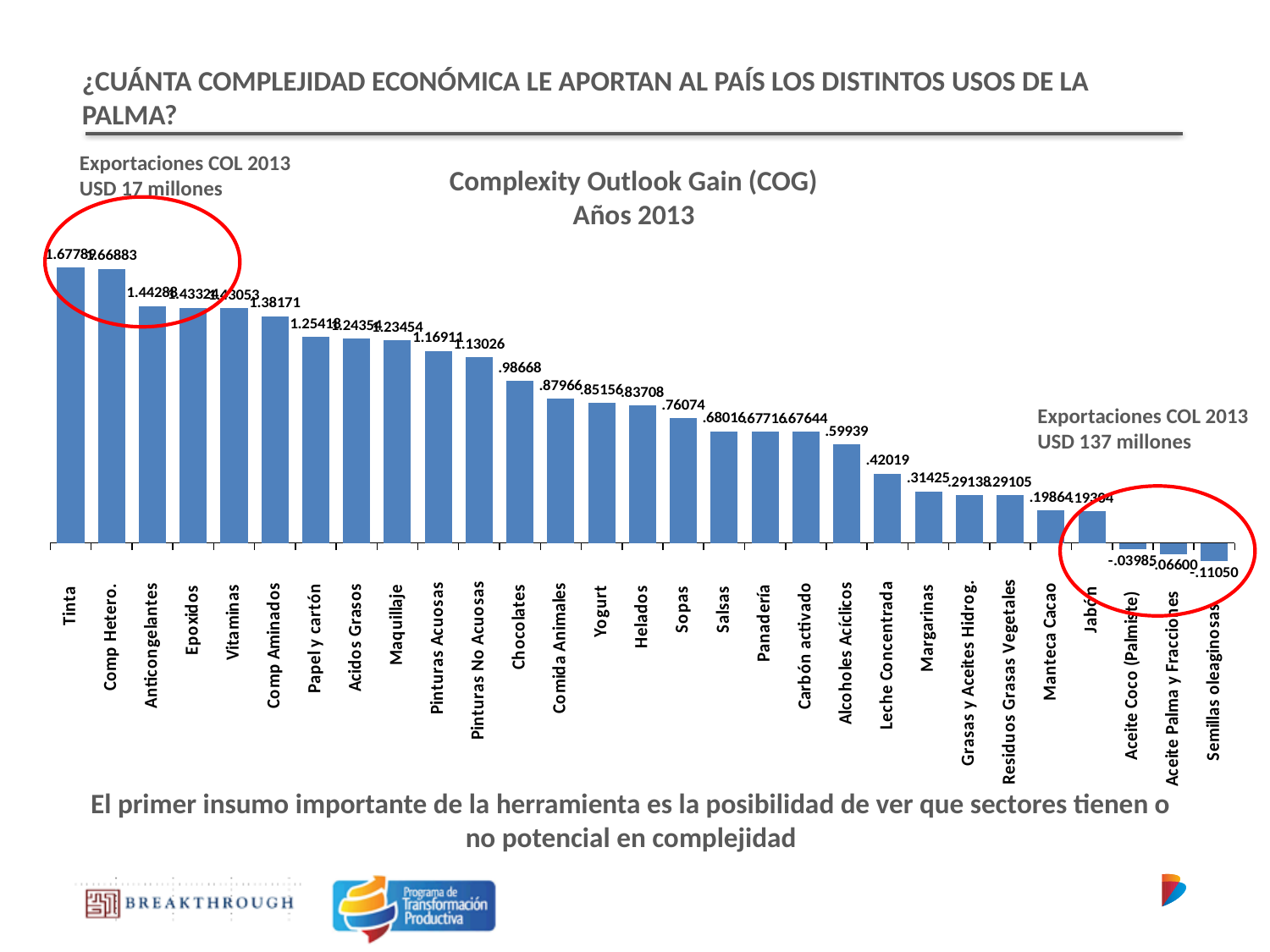
What type of chart is shown on the slide? bar chart What is the value for Sopas? .76074 What is the value for Leche Concentrada? .42019 How many categories are plotted on the x axis of the chart? 29 What is the value for Semillas oleaginosas? -.11050 Which category has the highest value in the chart? Tinta Do the values rise or fall moving from left to right along the x axis? fall Which category has the lowest value in the chart? Semillas oleaginosas What is the difference between the values for Chocolates and Sopas? .22594 What is the value for Chocolates? .98668 Which has a larger value, Margarinas or Leche Concentrada? Leche Concentrada What is the title of the chart? Complexity Outlook Gain (COG) Años 2013